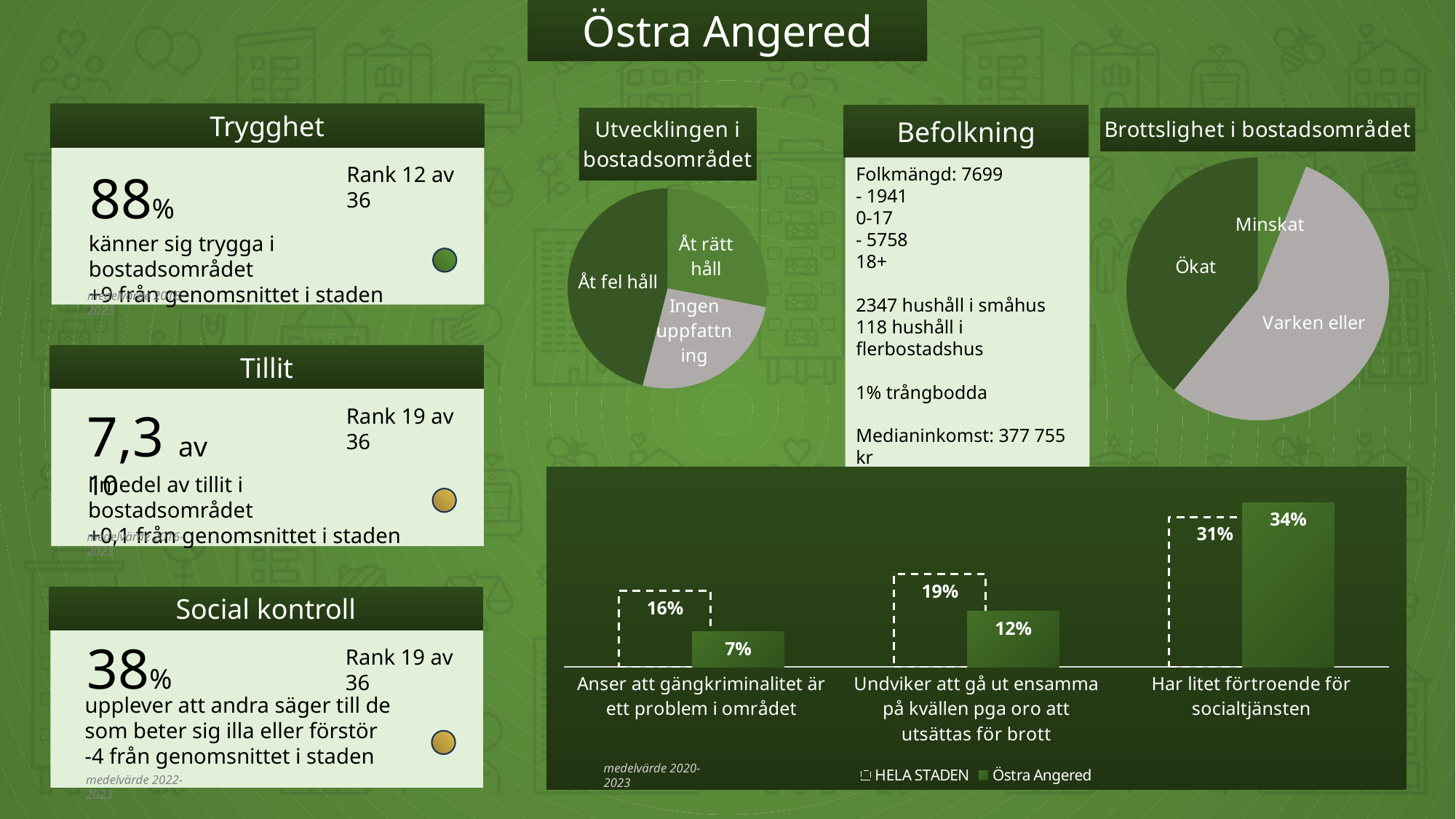
In the bottom bar chart, which is larger for 'Har litet förtroende för socialtjänsten': HELA STADEN or Östra Angered? Östra Angered In the bottom bar chart, which category has the highest value for Östra Angered? Har litet förtroende för socialtjänsten In the bottom bar chart, what is the difference between HELA STADEN and Östra Angered for 'Undviker att gå ut ensamma på kvällen pga oro att utsättas för brott'? 7% In the 'Brottslighet i bostadsområdet' pie chart, which slice is the largest? Varken eller In the bottom bar chart, what is the value for HELA STADEN for 'Anser att gängkriminalitet är ett problem i området'? 16% In the bottom bar chart, what is the value for Östra Angered for 'Undviker att gå ut ensamma på kvällen pga oro att utsättas för brott'? 12% How many categories are shown in the bottom bar chart? 3 How many slices does the 'Utvecklingen i bostadsområdet' pie chart have? 3 In the bottom bar chart, what is the value for Östra Angered for 'Har litet förtroende för socialtjänsten'? 34% What kind of chart is 'Brottslighet i bostadsområdet'? Pie chart In the bottom bar chart, which category has the lowest value for HELA STADEN? Anser att gängkriminalitet är ett problem i området How many series does the legend of the bottom bar chart list? 2